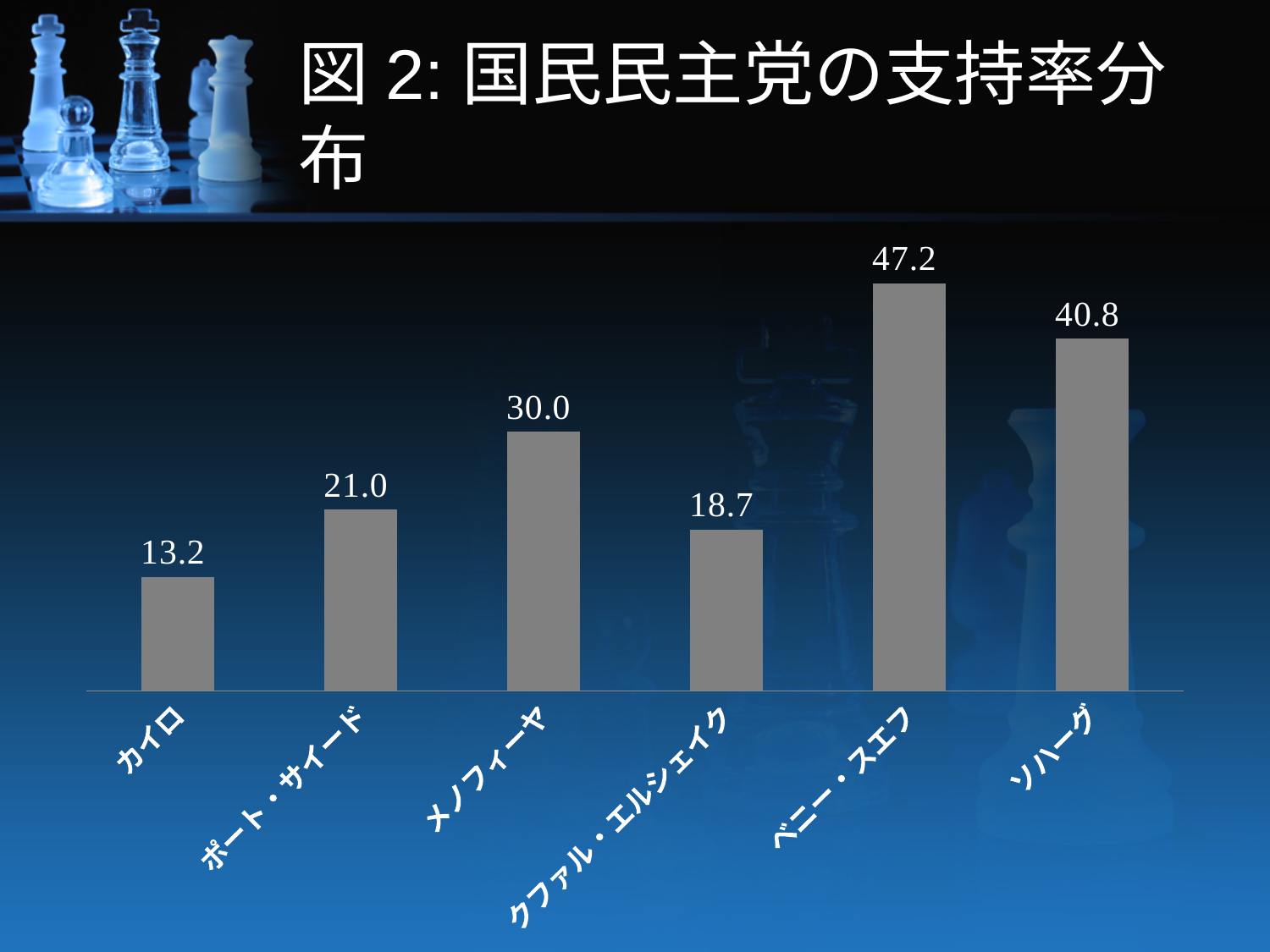
What is the value for カイロ? 13.2 What is the value for ソハーグ? 40.8 What is the title of the slide? 図 2: 国民民主党の支持率分布 What kind of chart is shown on the slide? Bar chart How many categories are shown in the chart? 6 What is the value for クファル・エルシェイク? 18.7 What is the difference between the values for メノフィーヤ and ポート・サイード? 9.0 Which category has the highest value? ベニー・スエフ What is the value for ベニー・スエフ? 47.2 Which category has the lowest value? カイロ What is the difference between the values for ベニー・スエフ and ソハーグ? 6.4 Which is larger, the value for ポート・サイード or the value for クファル・エルシェイク? ポート・サイード